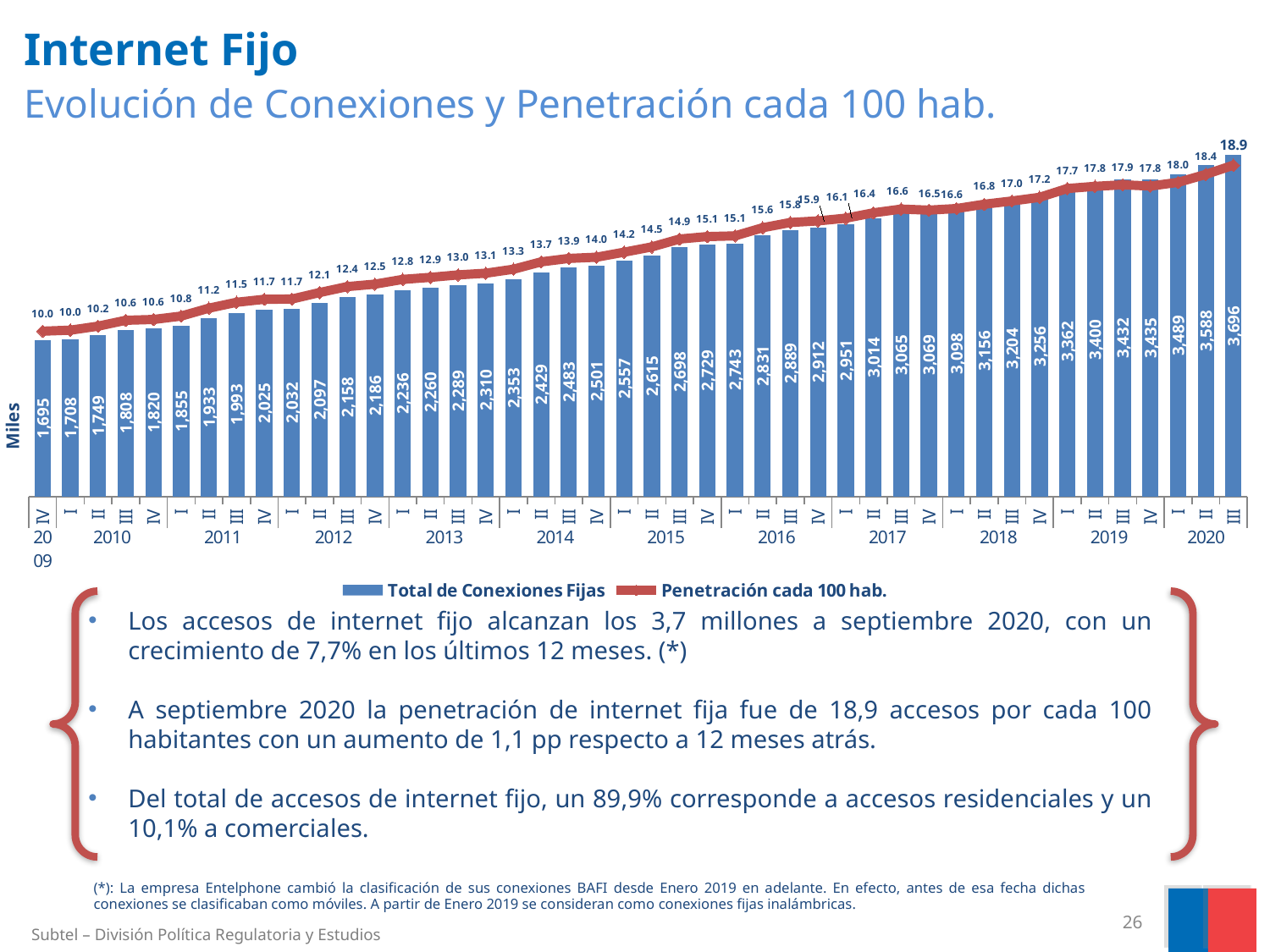
Which quarter has the highest Total de Conexiones Fijas? III 2020 How many series does the legend list? 2 Does the Penetración cada 100 hab. line generally rise or fall from 2009 to 2020? Rise What is the Penetración cada 100 hab. value for quarter I of 2015? 14.2 How many quarters are plotted on the chart? 44 Which quarter has the lowest Total de Conexiones Fijas? IV 2009 What is the value of Total de Conexiones Fijas for quarter III of 2020? 3,696 What is the difference in Total de Conexiones Fijas between quarter III of 2020 and quarter III of 2019? 264 What kind of chart is shown on the slide? Combined bar and line chart What is the Penetración cada 100 hab. value for quarter III of 2020? 18.9 What is the value of Total de Conexiones Fijas for quarter IV of 2009? 1,695 Which is larger, the Total de Conexiones Fijas for quarter IV of 2017 or for quarter I of 2018? I 2018